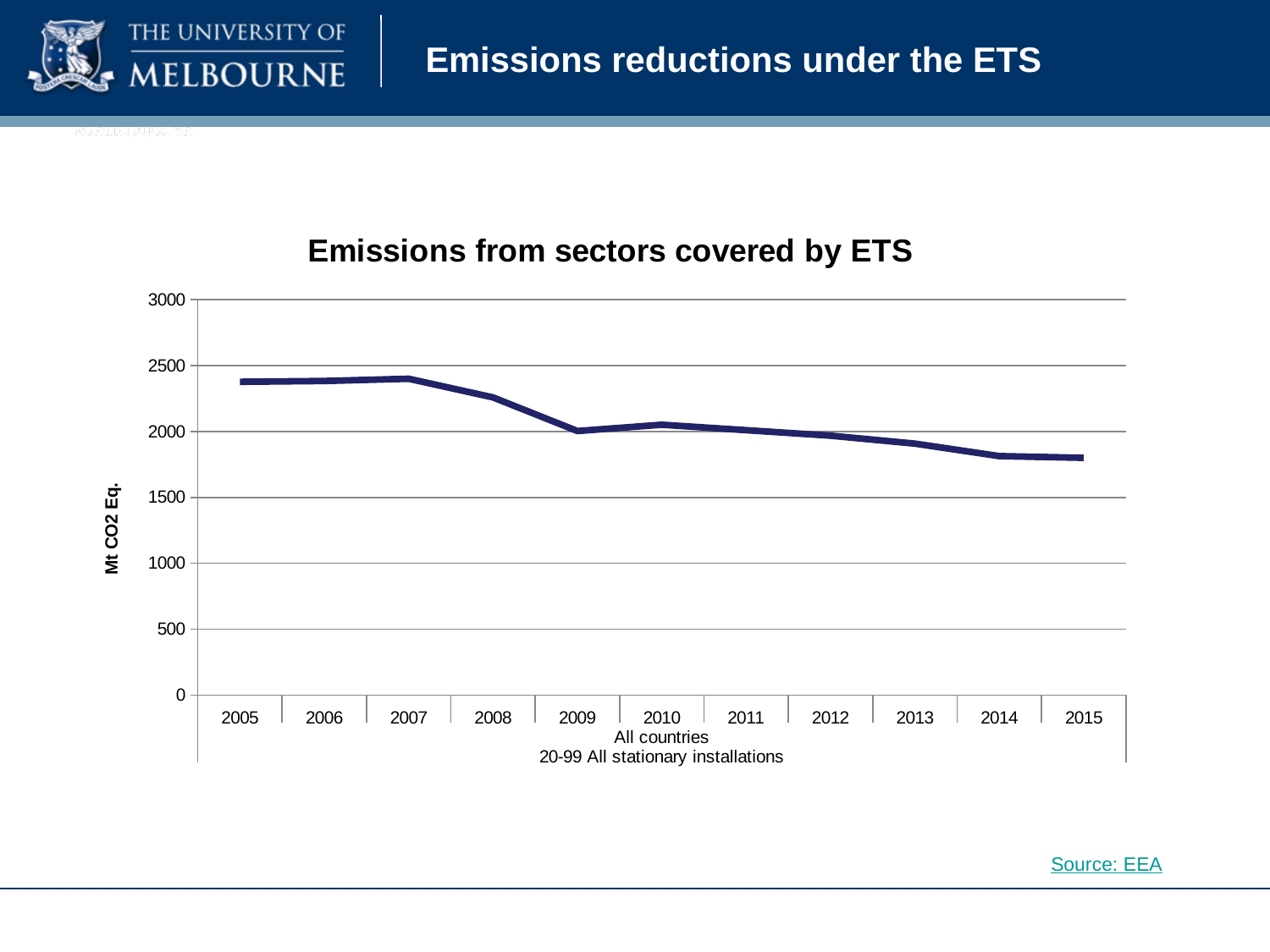
Is the value for 2014 greater or less than 2000 Mt CO2 Eq.? less Is the value for 2015 greater or less than 2000 Mt CO2 Eq.? less Is the value for 2008 greater or less than 2000 Mt CO2 Eq.? greater What kind of chart is shown on the slide? line chart Which year has the higher emissions value, 2005 or 2015? 2005 Do emissions generally rise or fall from 2005 to 2015 in the chart? fall How many years are plotted on the x axis of the chart? 11 Which year has the higher emissions value, 2008 or 2009? 2008 What is the label on the y axis of the chart? Mt CO2 Eq. What is the title of the chart? Emissions from sectors covered by ETS